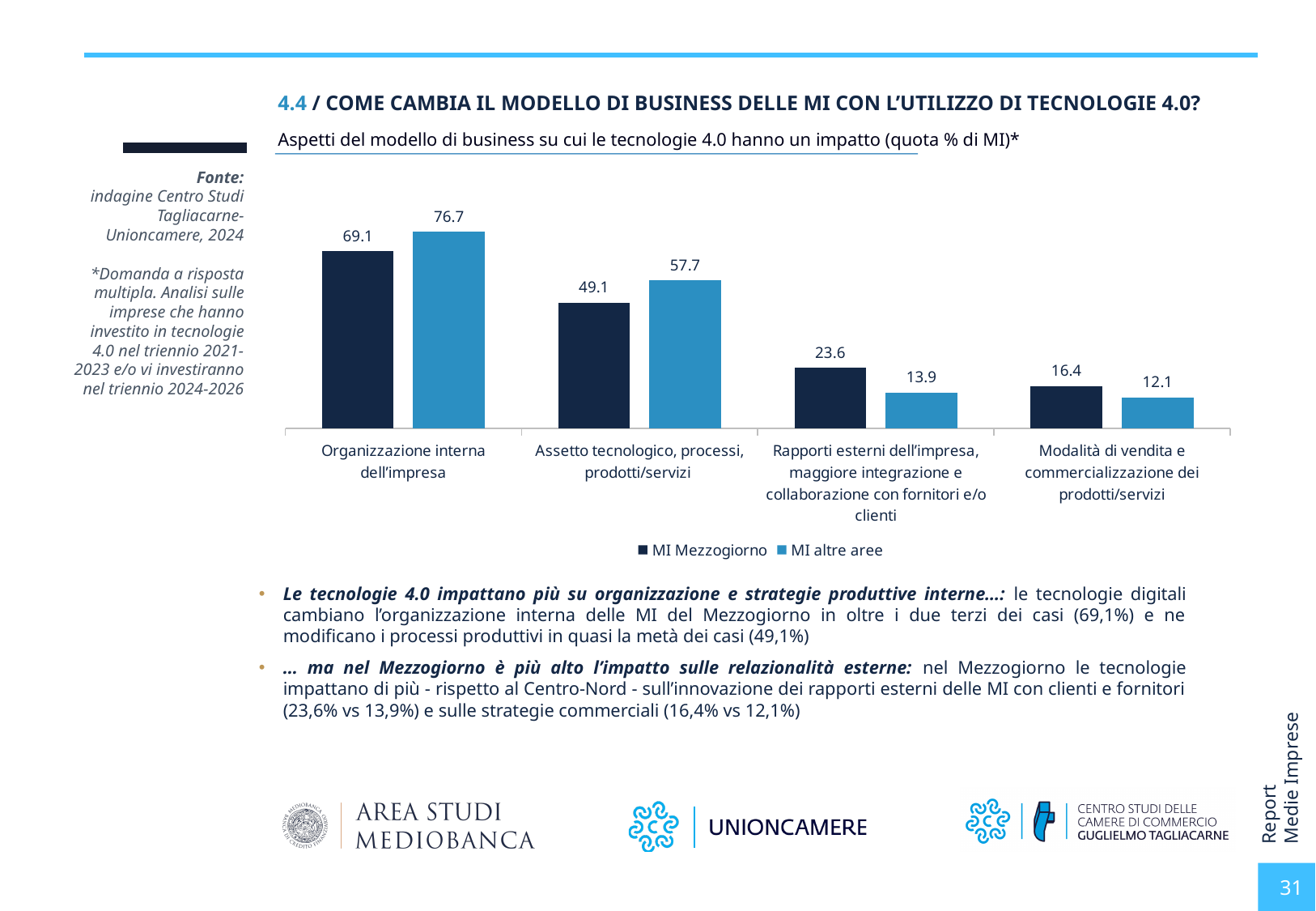
What kind of chart is shown on the slide? Bar chart Which category has the highest value for MI altre aree? Organizzazione interna dell'impresa What is the value for MI altre aree in the category "Modalità di vendita e commercializzazione dei prodotti/servizi"? 12.1 How many categories are shown on the x axis of the chart? 4 What is the value for MI altre aree in the category "Assetto tecnologico, processi, prodotti/servizi"? 57.7 What is the value for MI Mezzogiorno in the category "Organizzazione interna dell'impresa"? 69.1 Which category has the lowest value for MI Mezzogiorno? Modalità di vendita e commercializzazione dei prodotti/servizi What is the difference between MI altre aree and MI Mezzogiorno in the category "Organizzazione interna dell'impresa"? 7.6 Do the values for MI Mezzogiorno rise or fall from left to right across the categories? Fall How many series does the legend list? 2 Which colour represents the series MI altre aree in the chart? Light blue In the category "Rapporti esterni dell'impresa, maggiore integrazione e collaborazione con fornitori e/o clienti", which series has the larger value? MI Mezzogiorno